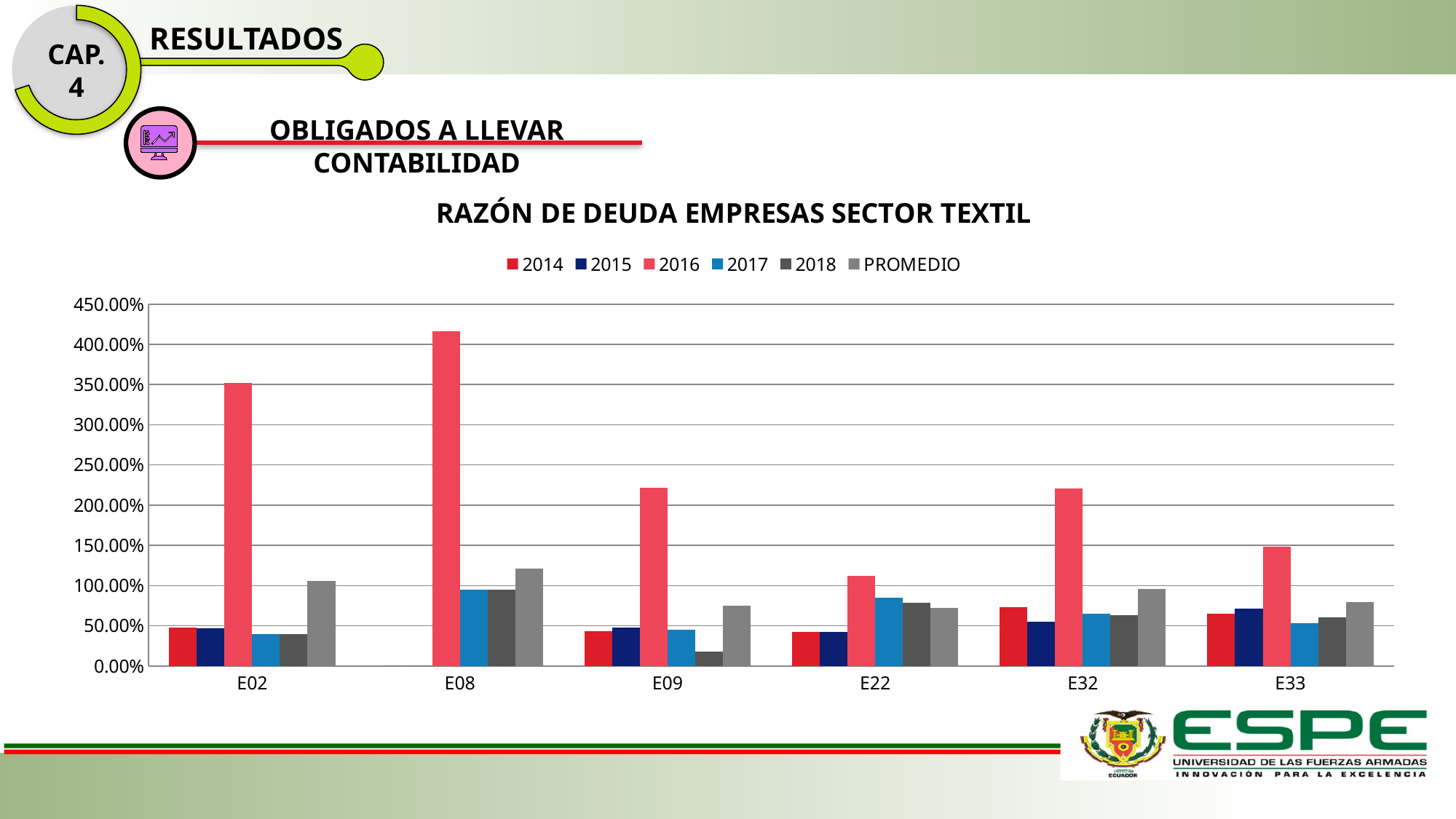
Which company has the highest PROMEDIO value? E08 Is the 2016 value for E02 greater or less than 300.00%? greater Is the 2018 value for E09 greater or less than 50.00%? less Which company has the lowest value for the 2018 series? E09 Which company has the highest value for the 2016 series? E08 Which is larger, the 2016 value for E32 or the 2016 value for E33? E32 Which is larger, the 2016 value for E02 or the 2016 value for E09? E02 Is the 2016 value for E08 greater or less than 400.00%? greater What kind of chart is shown on the slide? bar chart How many companies (categories) are shown on the x axis? 6 What is the title of the chart? RAZÓN DE DEUDA EMPRESAS SECTOR TEXTIL How many series does the legend list? 6